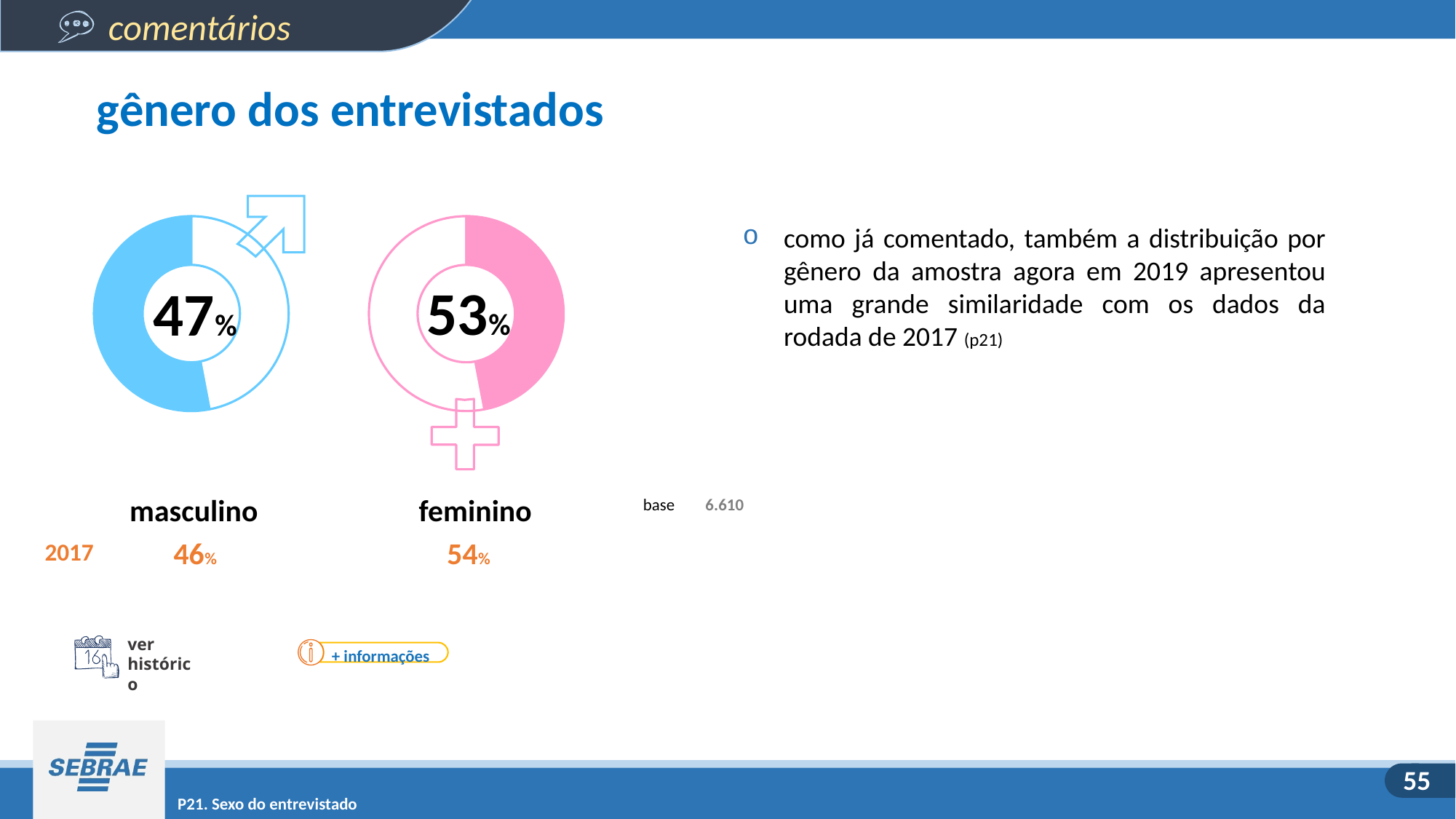
What kind of chart is used to show the gender distribution? donut (pie) chart How many gender categories are shown on the slide? 2 What percentage is shown in the masculino donut chart? 47% What was the masculino share in 2017, as shown below the chart? 46% Which gender has the larger share among the respondents, masculino or feminino? feminino By how many percentage points did the masculino share change from 2017 (46%) to the current value (47%)? 1 What colour is the feminino donut chart? pink What is the difference in percentage points between the feminino and masculino shares? 6 What is the base (number of respondents) shown on the slide? 6.610 Which gender has the smaller share among the respondents? masculino What percentage is shown in the feminino donut chart? 53% What was the feminino share in 2017, as shown below the chart? 54%